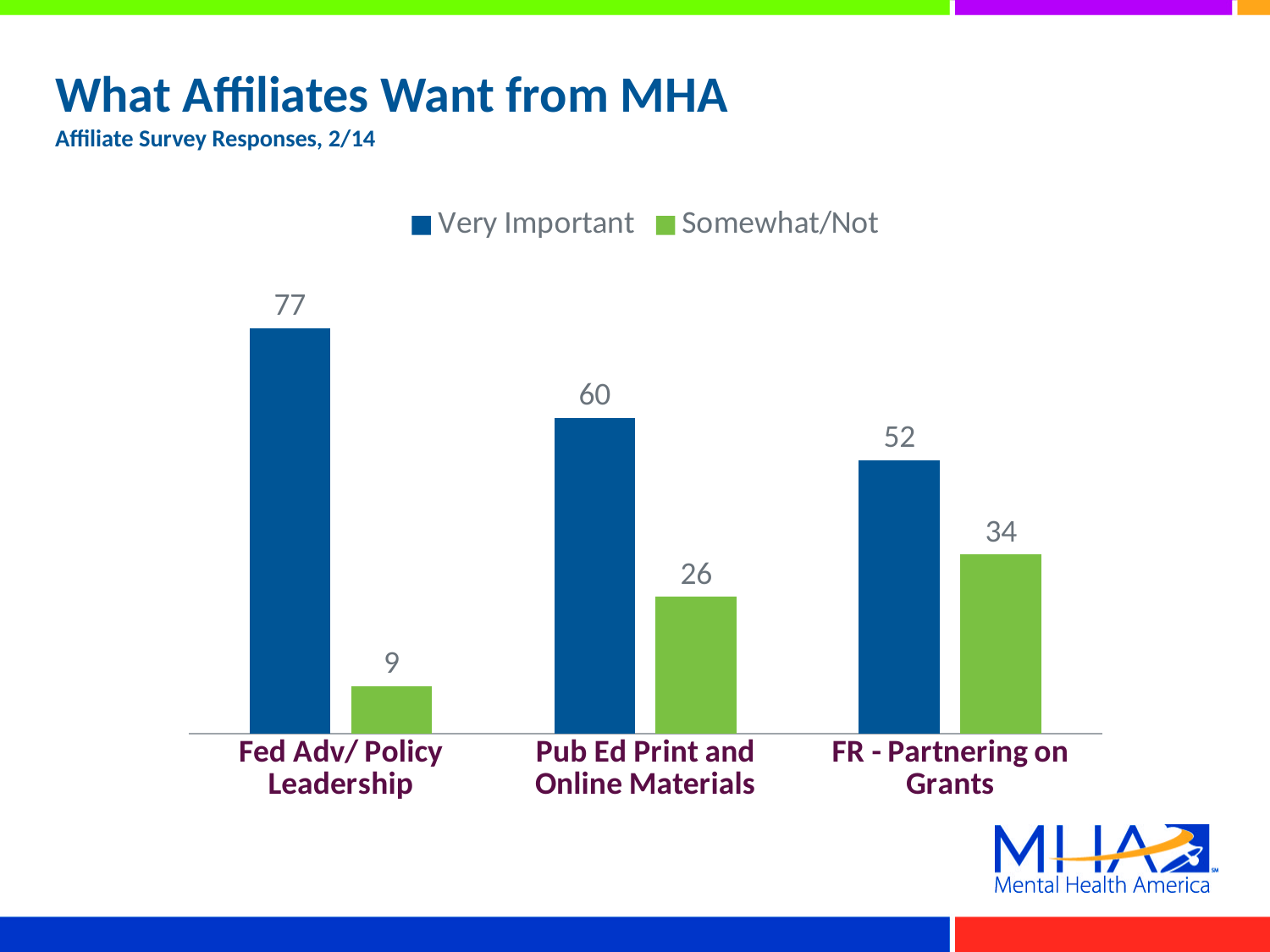
How many categories are shown on the x axis? 3 What kind of chart is shown on the slide? Bar chart Do the Very Important values rise or fall from left to right across the categories? Fall What is the Very Important value for Fed Adv/ Policy Leadership? 77 What colour are the Somewhat/Not bars? Green Which is larger: the Somewhat/Not value for FR - Partnering on Grants or the Somewhat/Not value for Pub Ed Print and Online Materials? FR - Partnering on Grants Which category has the highest Very Important value? Fed Adv/ Policy Leadership What is the difference between the Very Important and Somewhat/Not values for FR - Partnering on Grants? 18 What is the Very Important value for FR - Partnering on Grants? 52 What is the Somewhat/Not value for Pub Ed Print and Online Materials? 26 How many series does the legend list? 2 Which category has the lowest Somewhat/Not value? Fed Adv/ Policy Leadership